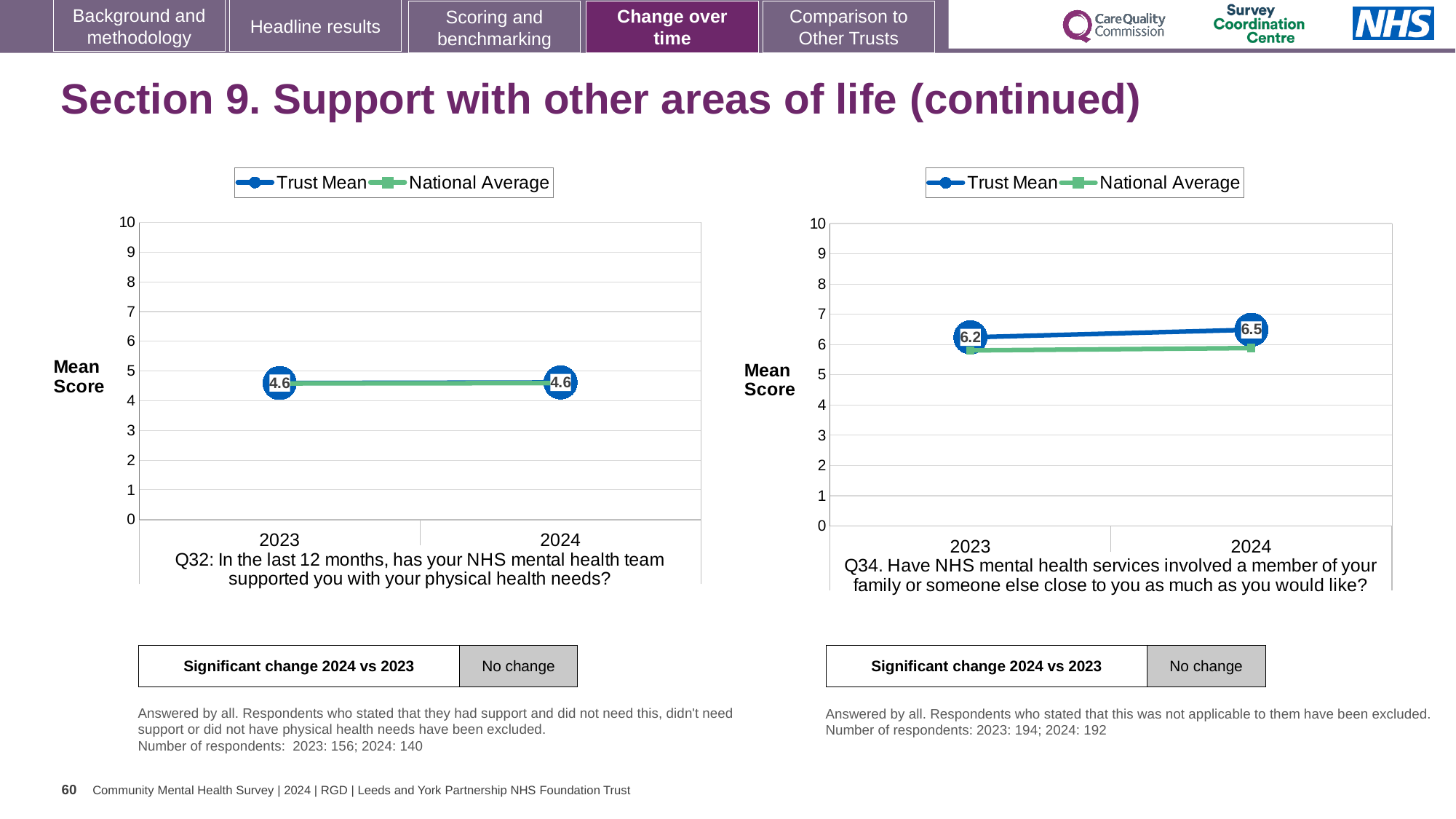
In the Q34 chart on the right, by how much did the Trust Mean change from 2023 to 2024? 0.3 In the Q34 chart on the right, what is the Trust Mean for 2023? 6.2 In the Q34 chart on the right, what is the Trust Mean for 2024? 6.5 How many years are plotted on the x axis of the Q32 chart on the left? 2 In the Q32 chart on the left, does the Trust Mean rise, fall or stay flat from 2023 to 2024? stay flat In the Q34 chart on the right, which year has the higher Trust Mean, 2023 or 2024? 2024 What type of chart is used for Q32 on the left? line chart How many series does the legend of the Q34 chart on the right list? 2 In the Q32 chart on the left, what is the Trust Mean for 2023? 4.6 In the Q32 chart on the left, what is the Trust Mean for 2024? 4.6 In the Q34 chart on the right, is the National Average for 2023 greater or less than 5? greater In the Q34 chart on the right, does the Trust Mean rise, fall or stay flat from 2023 to 2024? rise